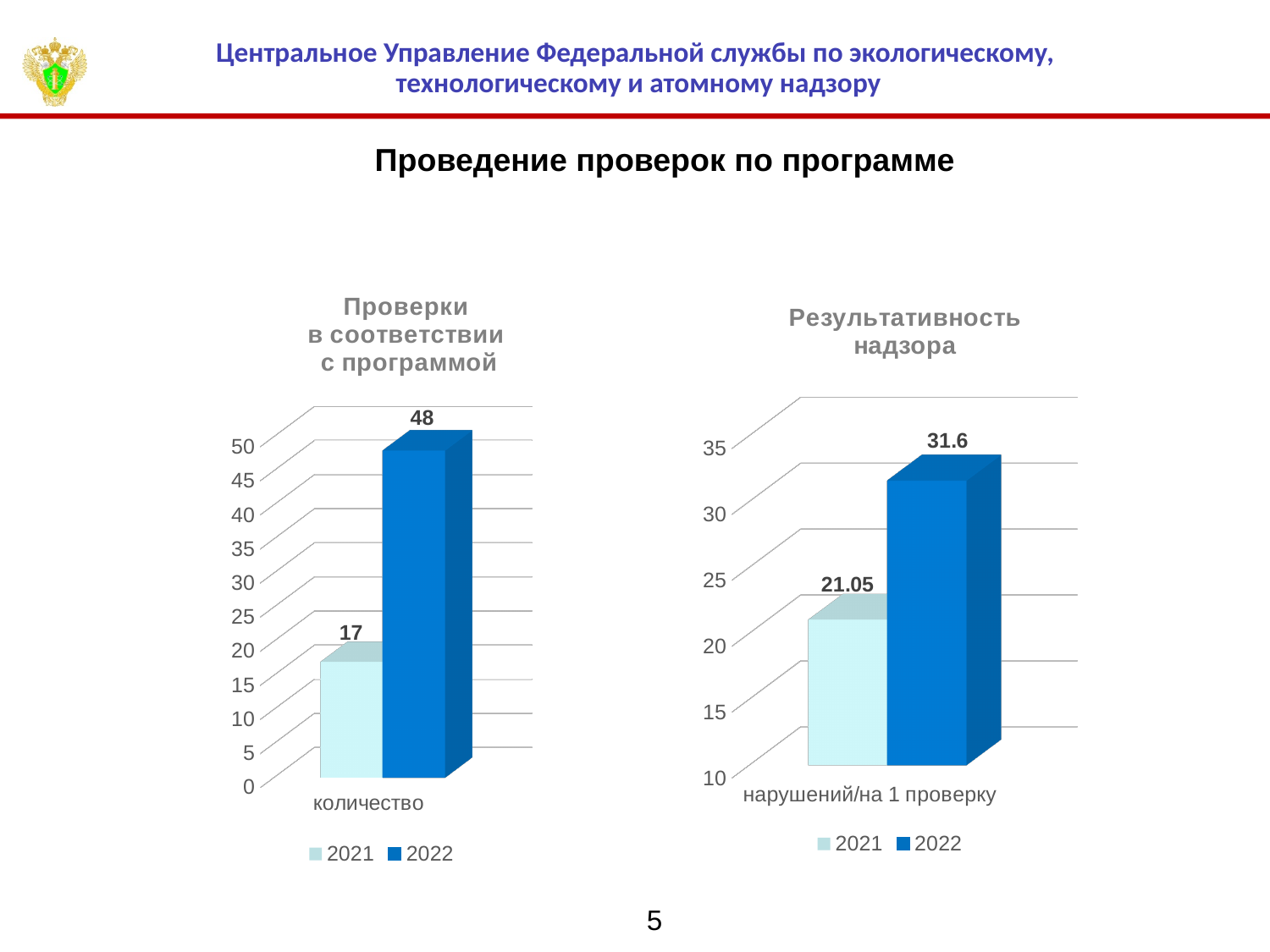
In the chart titled "Результативность надзора", what is the value for 2022? 31.6 In the chart titled "Проверки в соответствии с программой", what is the value for 2022? 48 In the chart titled "Результативность надзора", what is the difference between the 2022 and 2021 values? 10.55 What is the category label on the x axis of the chart titled "Проверки в соответствии с программой"? количество What is the category label on the x axis of the chart titled "Результативность надзора"? нарушений/на 1 проверку How many series does the legend of the chart titled "Результативность надзора" list? 2 What kind of chart is the chart titled "Проверки в соответствии с программой"? bar chart In the chart titled "Проверки в соответствии с программой", which series has the higher value, 2021 or 2022? 2022 In the chart titled "Результативность надзора", what is the value for 2021? 21.05 In the chart titled "Проверки в соответствии с программой", what is the value for 2021? 17 In the chart titled "Результативность надзора", which series has the lower value, 2021 or 2022? 2021 In the chart titled "Проверки в соответствии с программой", what is the difference between the 2022 and 2021 values? 31